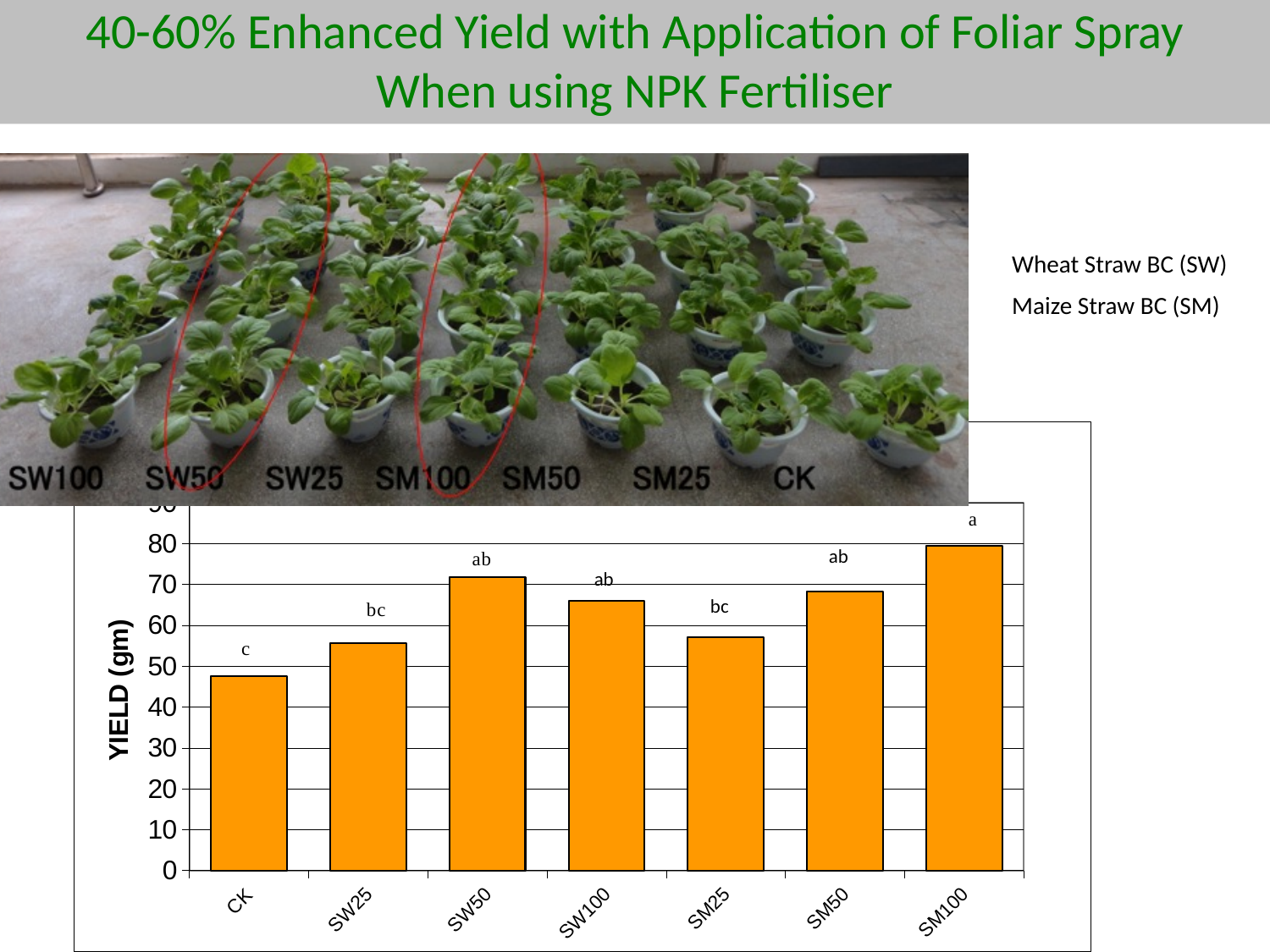
Which category has the highest yield in the chart? SM100 What is the label of the y axis of the chart? YIELD (gm) What letter label is printed above the SM100 bar? a Is the yield for SW50 greater or less than 60? greater What kind of chart is shown on the slide? bar chart Which has the larger yield, SM25 or SM50? SM50 Is the yield for SM25 greater or less than 60? less Is the yield for CK greater or less than 50? less Which category has the lowest yield in the chart? CK Which has the larger yield, SW50 or SW100? SW50 How many categories are plotted on the x axis of the chart? 7